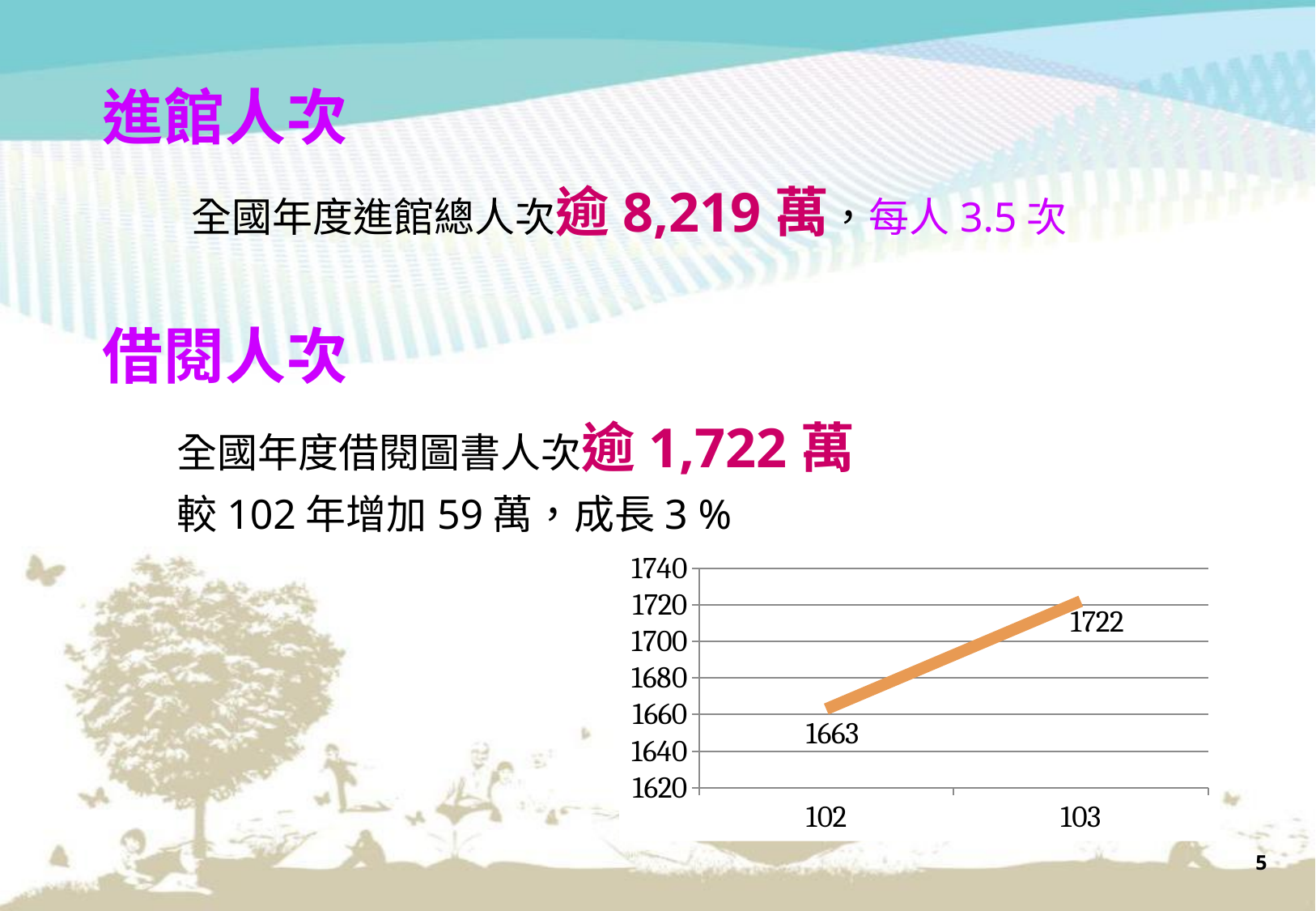
What kind of chart is shown on the slide? line chart Does the line rise or fall from 102 to 103? rise What is the difference between the values for 103 and 102 in the line chart? 59 How many data points are plotted in the line chart? 2 What is the value plotted for 103 in the line chart? 1722 Which year has the highest value in the line chart? 103 What colour is the line in the chart? orange Which year has the higher value in the line chart, 102 or 103? 103 Which year has the lowest value in the line chart? 102 What is the value plotted for 102 in the line chart? 1663 Is the value for 103 greater or less than 1700? greater Is the value for 102 greater or less than 1680? less